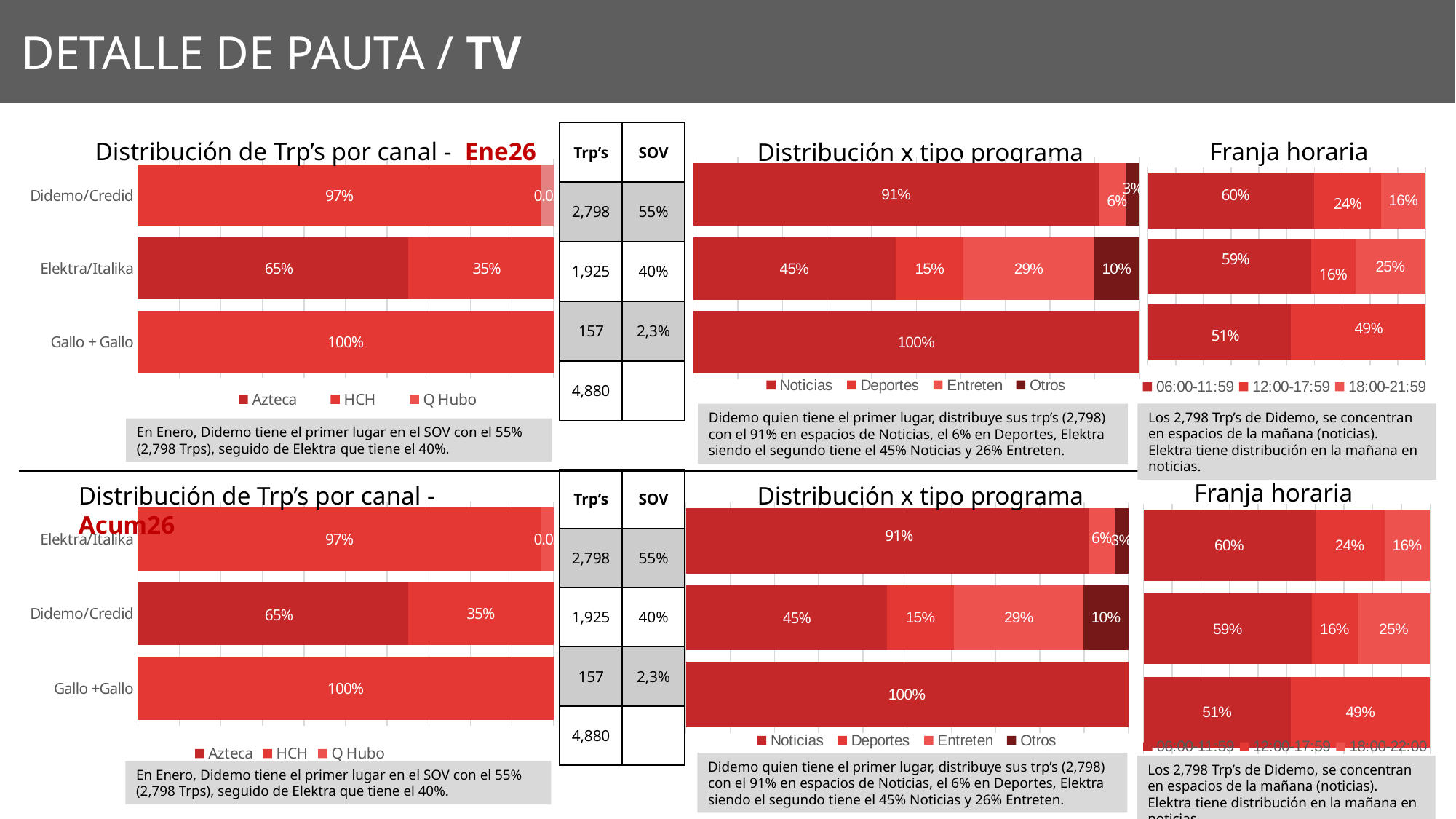
In the top 'Franja horaria' chart, what is the 06:00-11:59 value for Gallo + Gallo? 51% In the top 'Franja horaria' chart, what is the difference between the 06:00-11:59 and 18:00-21:59 values for Didemo/Credid? 44 percentage points In the top 'Franja horaria' chart, how many series does the legend list? 3 In the bottom-left chart 'Distribución de Trp's por canal - Acum26', what is the Azteca value for Didemo/Credid? 65% In the top 'Distribución x tipo programa' chart, which is larger for Elektra/Italika: Entreten or Deportes? Entreten In the top 'Distribución x tipo programa' chart, what is the Otros value for Elektra/Italika? 10% In the top 'Distribución x tipo programa' chart, how many categories are plotted? 3 In the top 'Distribución x tipo programa' chart, what are the legend entries? Noticias, Deportes, Entreten, Otros In the top 'Distribución x tipo programa' chart, what is the Noticias value for Elektra/Italika? 45% In the top-left chart 'Distribución de Trp's por canal - Ene26', what kind of chart is shown? bar chart In the top-left chart 'Distribución de Trp's por canal - Ene26', how many series does the legend list? 3 In the top 'Distribución x tipo programa' chart, which category has the highest Noticias share? Gallo + Gallo